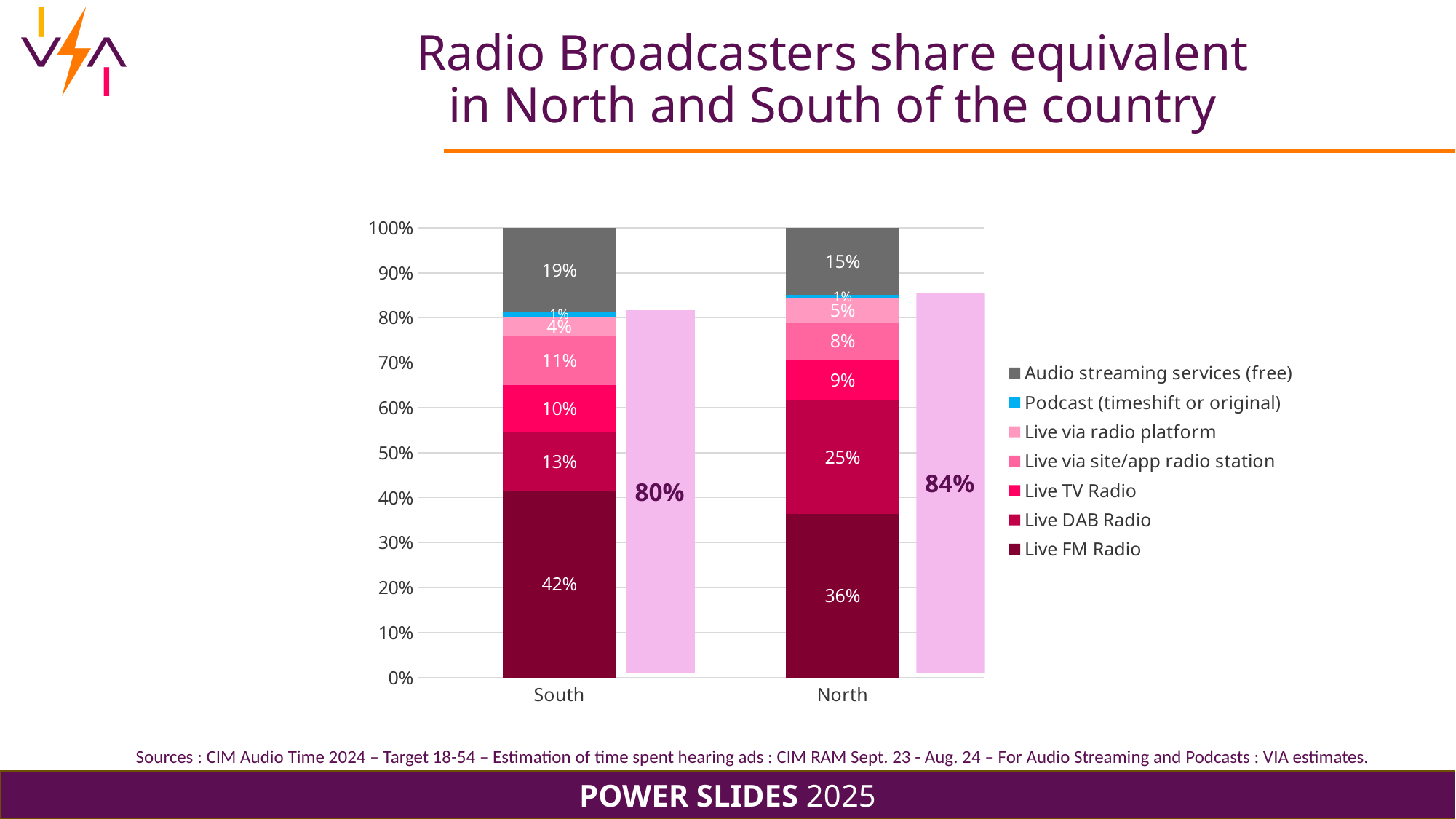
What is the value for Audio streaming services (free) in the South? 19% What kind of chart is shown on the slide? Stacked bar chart Which segment is the largest in the South stacked bar? Live FM Radio How many series does the legend list? 7 Which segment is the smallest in the North stacked bar? Podcast (timeshift or original) What is the value for Live FM Radio in the South? 42% What is the value for Live DAB Radio in the North? 25% Which region has the larger Live via site/app radio station value, South or North? South How many regions are shown on the x axis? 2 Which legend entry is shown in grey? Audio streaming services (free) What is the radio broadcasters share shown in the light pink bar for the North? 84% What is the difference between the Live DAB Radio values for North and South? 12%